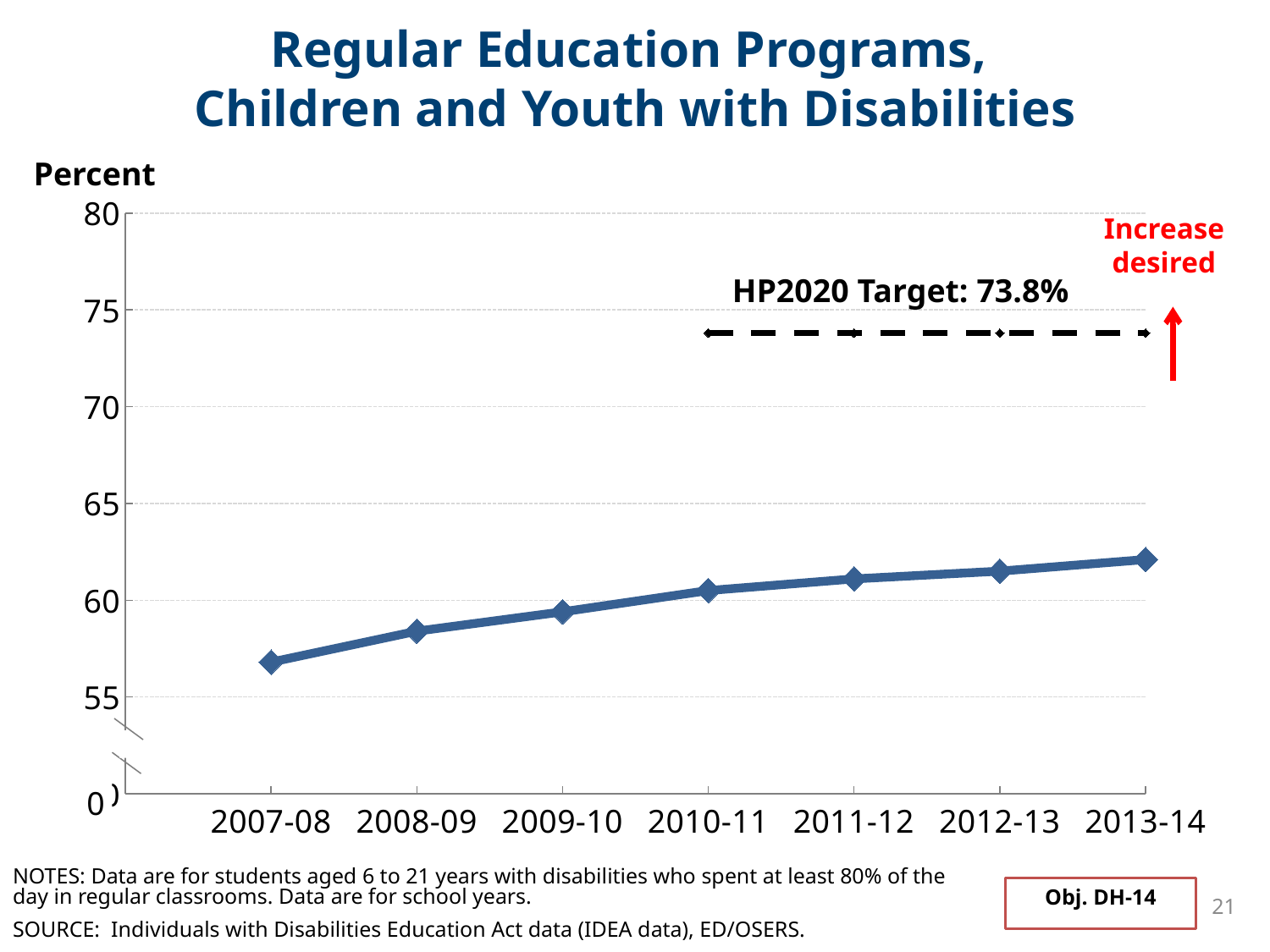
Which school year has the lowest plotted value? 2007-08 How many school years are plotted on the x axis? 7 Is the value for 2010-11 greater or less than 65? less Is the value for 2013-14 greater or less than 60? greater What is the label on the vertical axis of the chart? Percent Which is larger, the value for 2008-09 or the value for 2012-13? 2012-13 Is the value for 2007-08 greater or less than 60? less Which school year has the highest plotted value? 2013-14 Do the plotted values rise or fall from 2007-08 to 2013-14? rise What direction of change does the red arrow on the chart indicate is desired? Increase desired What is the HP2020 Target shown on the chart? 73.8% What kind of chart is shown on the slide? line chart